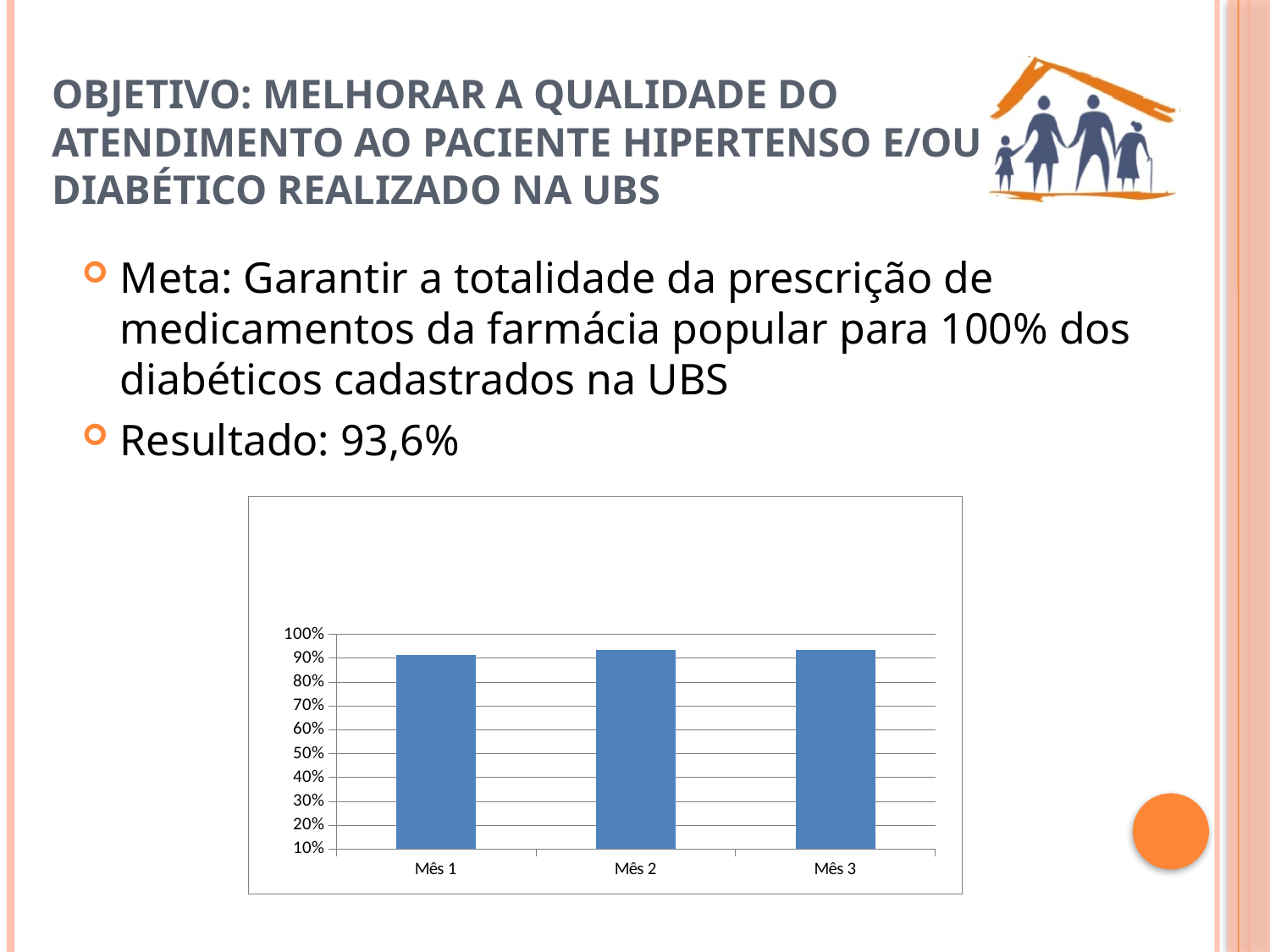
What is the highest tick value shown on the y axis of the chart? 100% Which is larger, the value for Mês 1 or the value for Mês 3? Mês 3 Is the value for Mês 3 greater or less than 100%? less Which category has the lowest bar in the chart? Mês 1 What kind of chart is shown on the slide? bar chart Is the value for Mês 1 greater or less than 80%? greater What is the label of the first category on the x axis of the chart? Mês 1 How many categories are shown on the x axis of the chart? 3 Which is larger, the value for Mês 1 or the value for Mês 2? Mês 2 Is the value for Mês 3 greater or less than 80%? greater